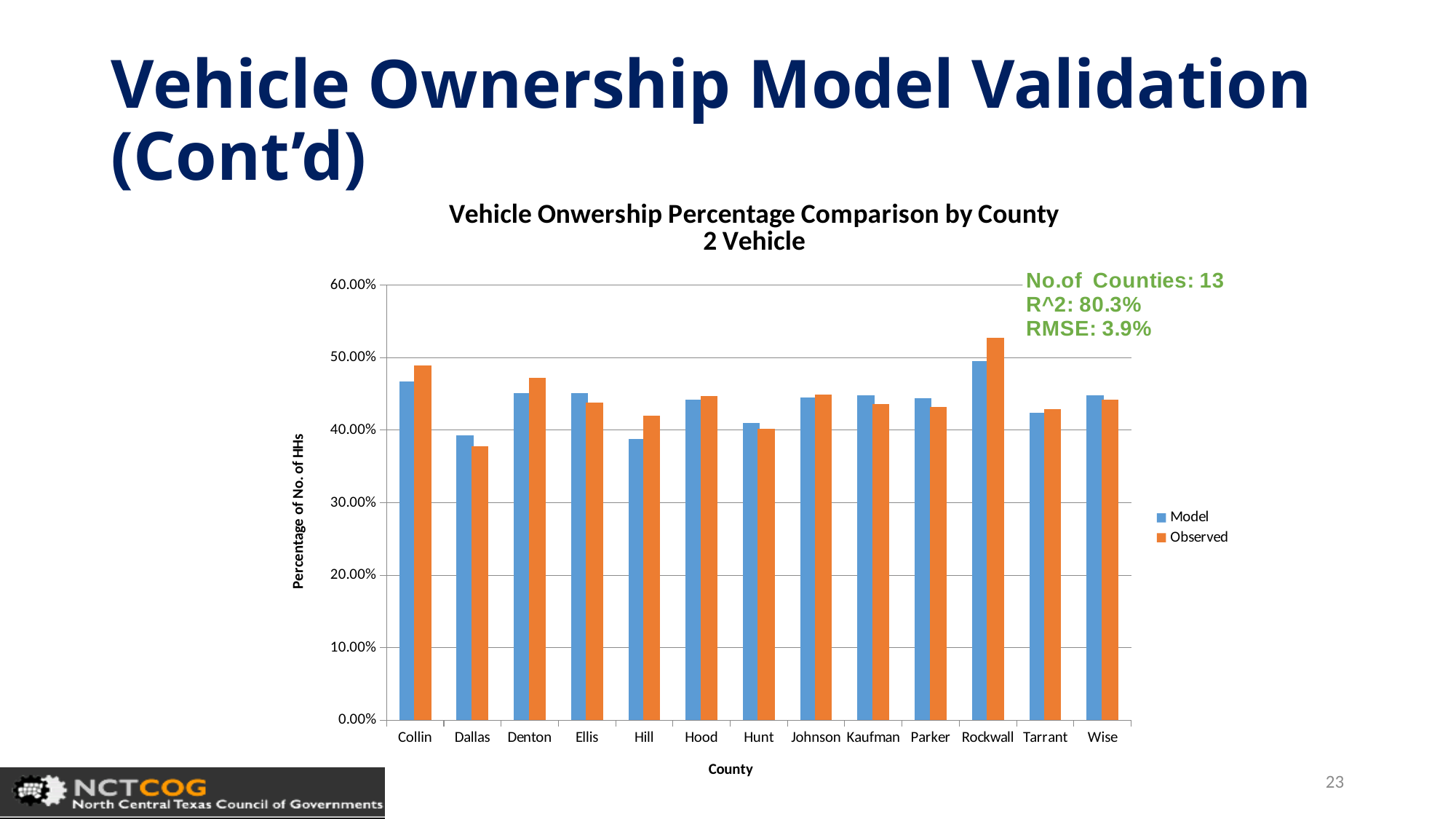
How many counties are shown on the x axis of the chart? 13 Which county has the highest Model value? Rockwall What kind of chart is shown on the slide? bar chart Which county has the highest Observed value? Rockwall Is the Model value for Collin greater or less than 50.00%? less Is the Observed value for Rockwall greater or less than 50.00%? greater Which county has the lowest Observed value? Dallas How many series does the chart's legend list? 2 Is the Observed value for Dallas greater or less than 40.00%? less For Dallas, which is larger, the Model value or the Observed value? Model For Collin, which is larger, the Model value or the Observed value? Observed What R^2 value is printed on the chart? 80.3%